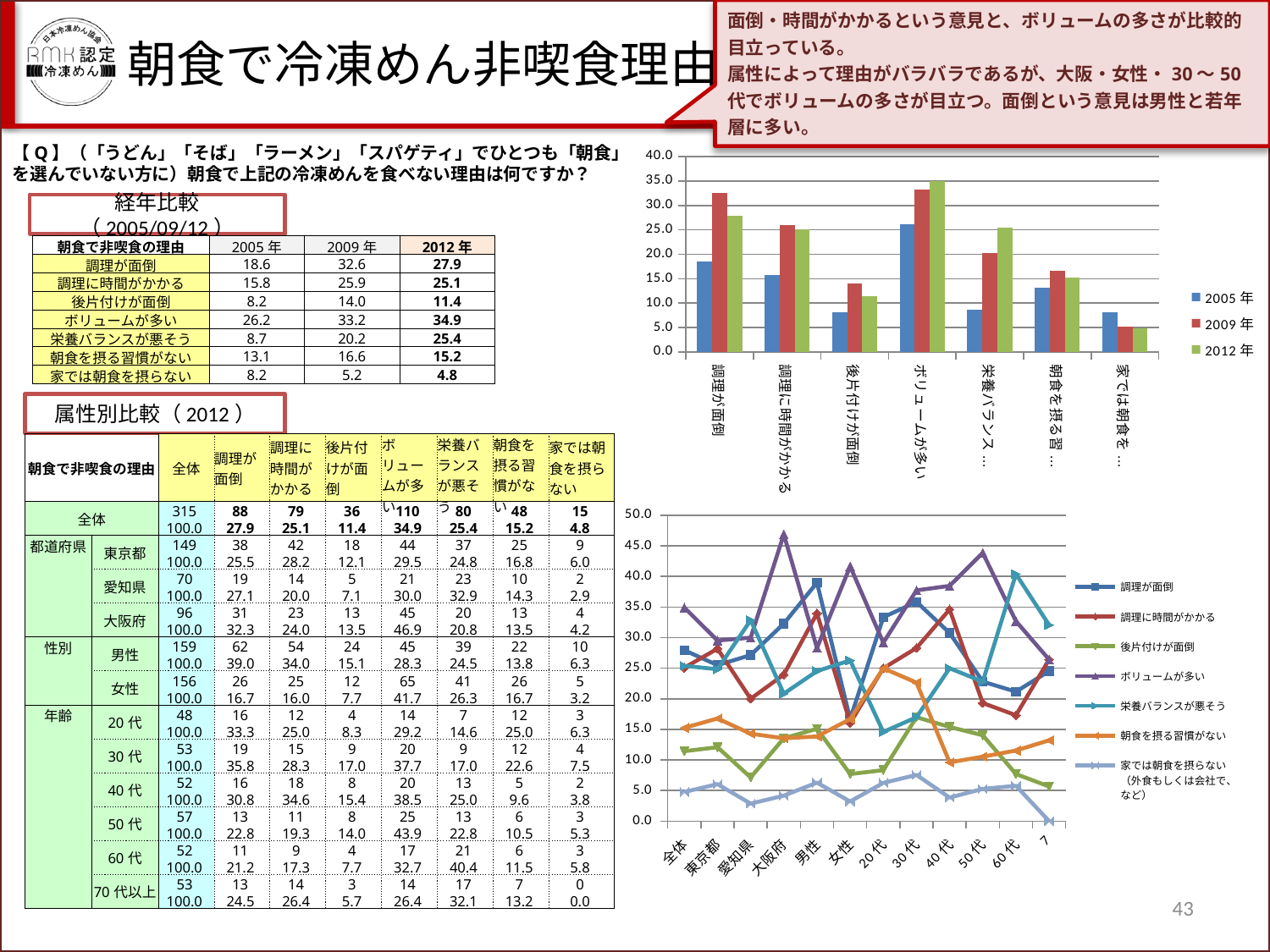
In the top-right bar chart, is the 2005年 value for 後片付けが面倒 greater or less than 10.0? less What kind of chart is the bottom-right chart showing 調理が面倒, ボリュームが多い and other reasons by attribute? line chart In the bottom-right line chart, which series reaches the highest point on the chart? ボリュームが多い In the top-right bar chart, is the 2009年 value for 調理が面倒 greater or less than 30.0? greater How many series does the legend of the top-right bar chart list? 3 What kind of chart is the top-right chart comparing 2005年, 2009年 and 2012年? bar chart In the top-right bar chart, for 栄養バランスが悪そう, which is larger: the 2009年 bar or the 2012年 bar? 2012年 How many categories are shown on the x axis of the top-right bar chart? 7 In the top-right bar chart, which category has the lowest 2012年 bar? 家では朝食を摂らない In the bottom-right line chart, is the value of 調理が面倒 for 男性 greater or less than 35.0? greater How many series does the legend of the bottom-right line chart list? 7 In the top-right bar chart, which category has the highest 2012年 bar? ボリュームが多い